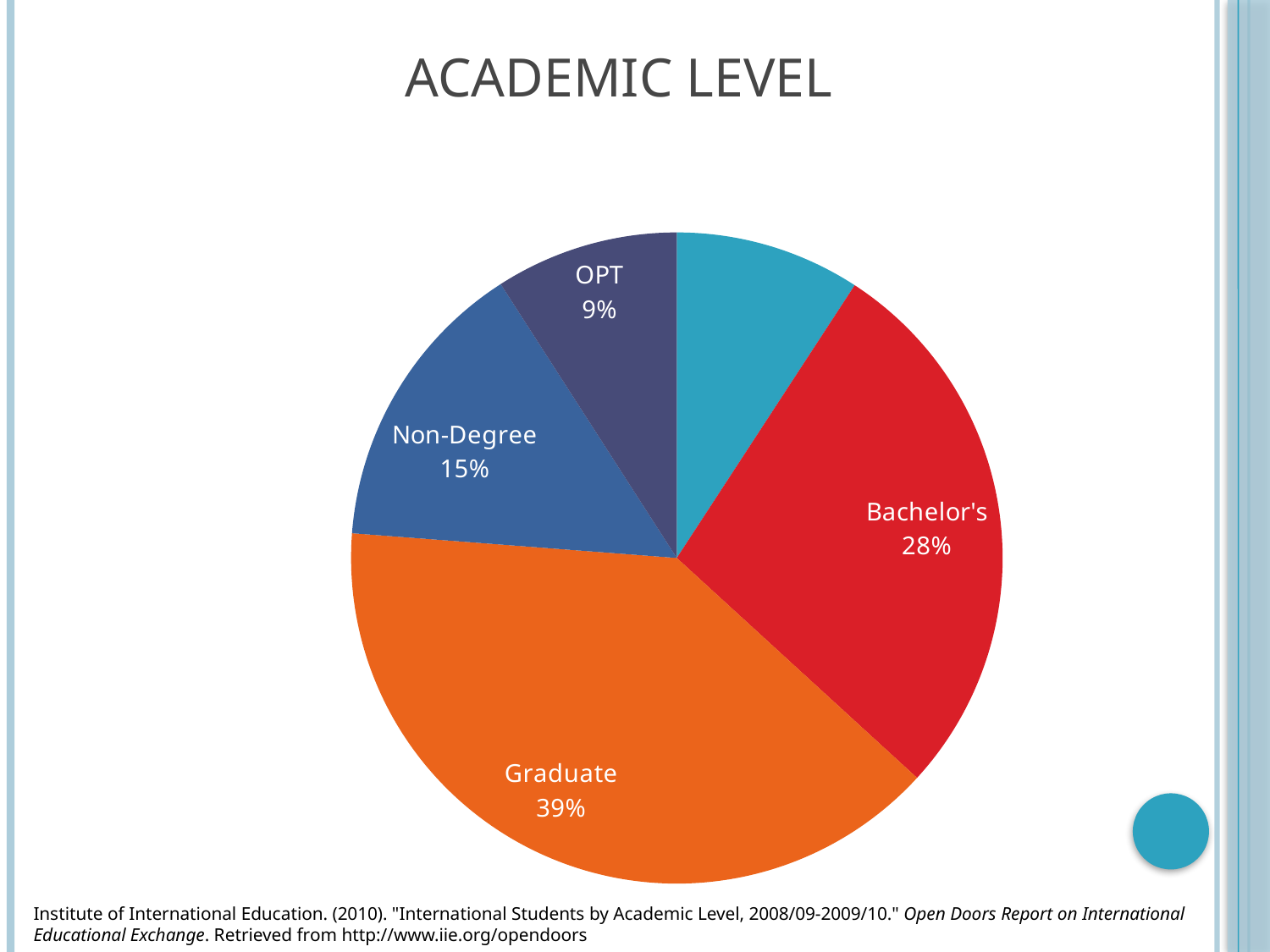
What is the title of the chart? ACADEMIC LEVEL What is the value shown for Bachelor's? 28% How many slices does the pie chart have? 5 What is the value labelled for OPT? 9% What share of the pie does Graduate represent? 39% What is the difference in percentage points between Non-Degree and OPT? 6% What is the difference in percentage points between Graduate and Bachelor's? 11% What percentage is shown for Non-Degree? 15% Which is larger, the Bachelor's slice or the Non-Degree slice? Bachelor's Which labelled category has the largest slice of the pie? Graduate Which is larger, the Non-Degree slice or the OPT slice? Non-Degree What kind of chart is shown on the slide? Pie chart